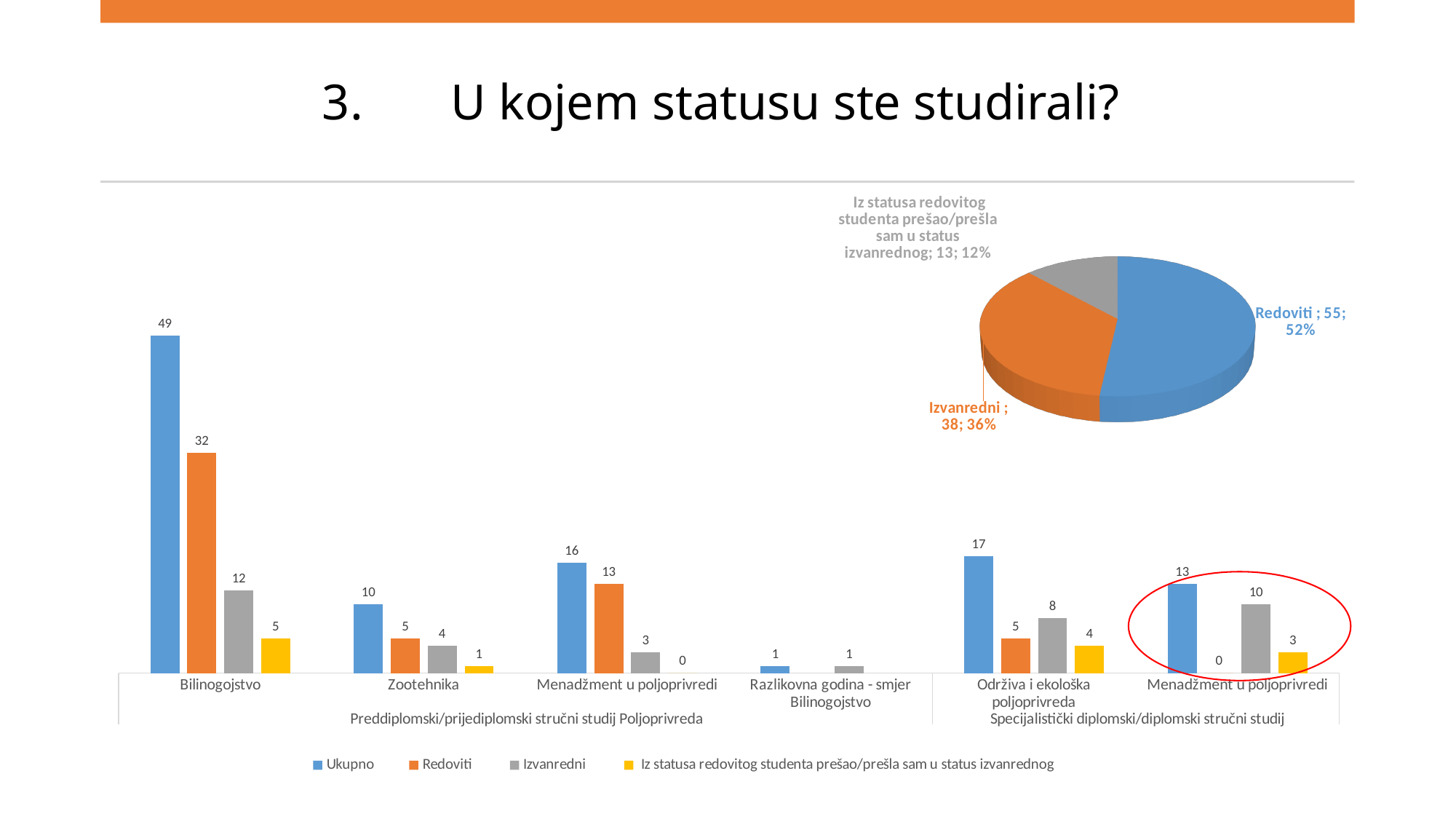
In the bar chart, what is the difference between the Ukupno and Redoviti values for Bilinogojstvo? 17 What kind of chart is the chart in the top right of the slide? Pie chart How many categories are shown on the x axis of the bar chart? 6 In the bar chart, what is the Izvanredni value for Menadžment u poljoprivredi under Specijalistički diplomski/diplomski stručni studij? 10 In the bar chart, what is the Ukupno value for Bilinogojstvo? 49 In the bar chart, which is larger for Održiva i ekološka poljoprivreda: the Redoviti value or the Izvanredni value? Izvanredni In the pie chart, what is the value for Izvanredni? 38 In the bar chart, what is the Redoviti value for Zootehnika? 5 In the bar chart, which category has the lowest Ukupno value? Razlikovna godina - smjer Bilinogojstvo In the pie chart, what share does the Redoviti slice have? 52% In the bar chart, which category has the highest Ukupno value? Bilinogojstvo How many series does the legend of the bar chart list? 4